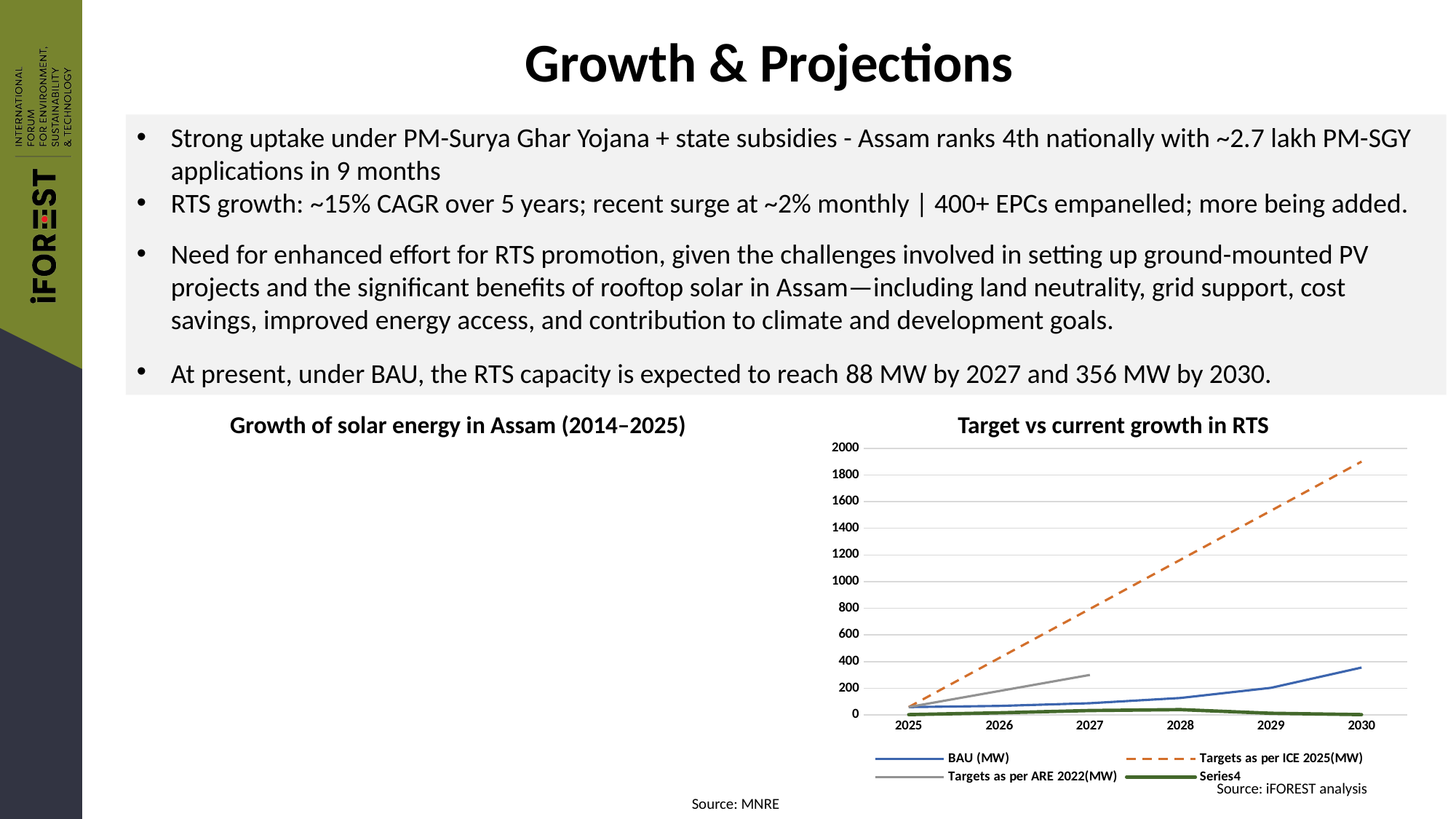
In the 'Target vs current growth in RTS' chart, which series reaches the highest value in 2030? Targets as per ICE 2025(MW) In the 'Target vs current growth in RTS' chart, is the value for Targets as per ICE 2025(MW) in 2028 greater or less than 1000? greater In the 'Target vs current growth in RTS' chart, is the value for Targets as per ARE 2022(MW) in 2027 greater or less than 200? greater In the 'Target vs current growth in RTS' chart, how many series does the legend list? 4 In the 'Target vs current growth in RTS' chart, is the value for Targets as per ICE 2025(MW) in 2030 greater or less than 1800? greater In the 'Target vs current growth in RTS' chart, which series is drawn with a dashed line? Targets as per ICE 2025(MW) In the 'Target vs current growth in RTS' chart, which series has the lowest value in 2030? Series4 In the 'Target vs current growth in RTS' chart, does the BAU (MW) line rise or fall from 2025 to 2030? rise In the 'Target vs current growth in RTS' chart, how many years are shown on the x axis? 6 In the 'Target vs current growth in RTS' chart, which is larger in 2030: BAU (MW) or Targets as per ICE 2025(MW)? Targets as per ICE 2025(MW) What kind of chart is 'Target vs current growth in RTS'? line chart